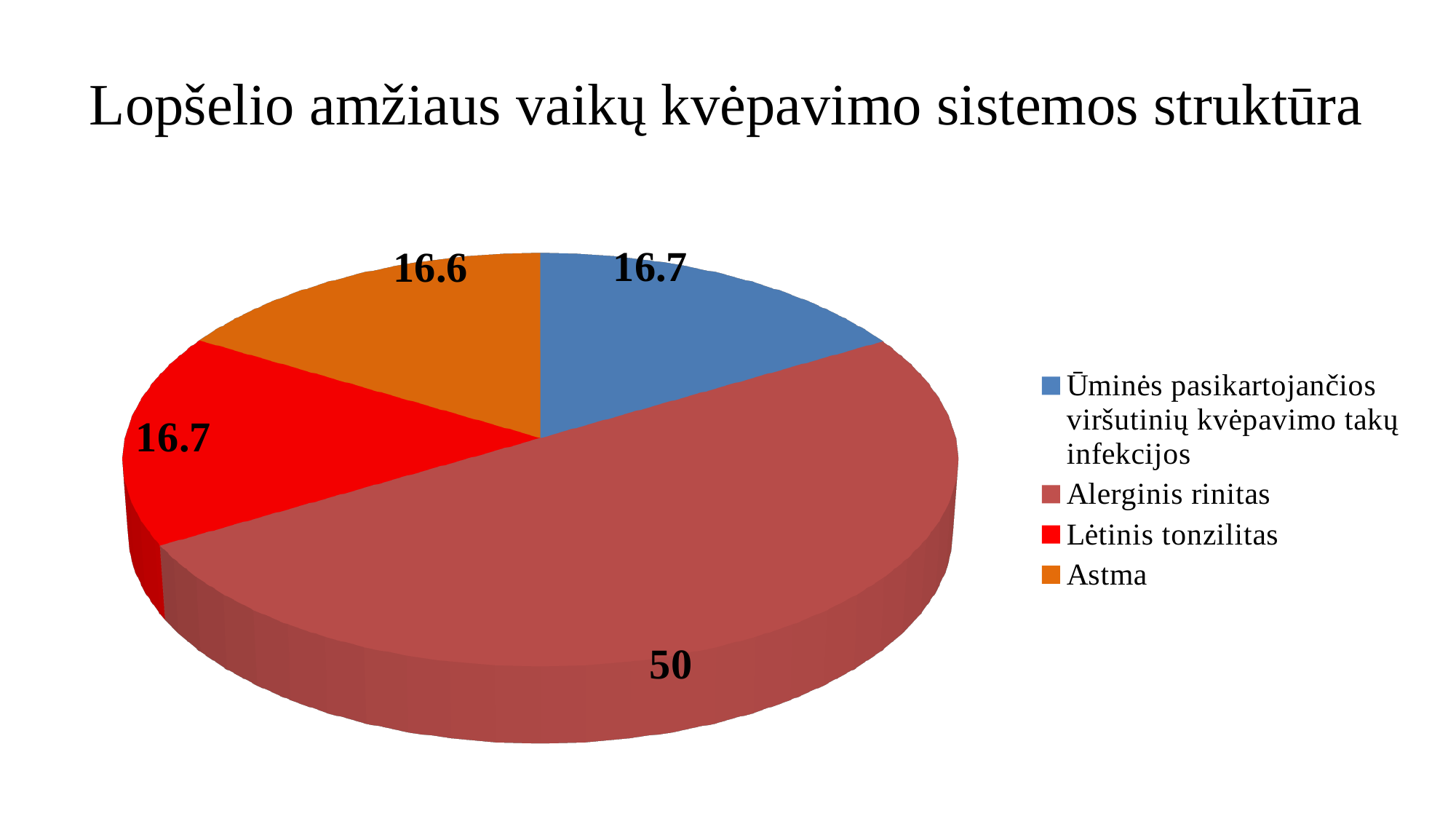
How many slices does the pie chart have? 4 What is the value shown for Astma? 16.6 What kind of chart is shown on the slide? Pie chart Which category is shown in orange in the legend? Astma What is the value shown for Ūminės pasikartojančios viršutinių kvėpavimo takų infekcijos? 16.7 What is the difference between the values for Alerginis rinitas and Astma? 33.4 What is the title of the chart? Lopšelio amžiaus vaikų kvėpavimo sistemos struktūra Which category has the largest slice of the pie? Alerginis rinitas What is the value shown for Lėtinis tonzilitas? 16.7 Which is larger, the value for Alerginis rinitas or the value for Astma? Alerginis rinitas What is the difference between the values for Alerginis rinitas and Lėtinis tonzilitas? 33.3 What is the value shown for Alerginis rinitas? 50